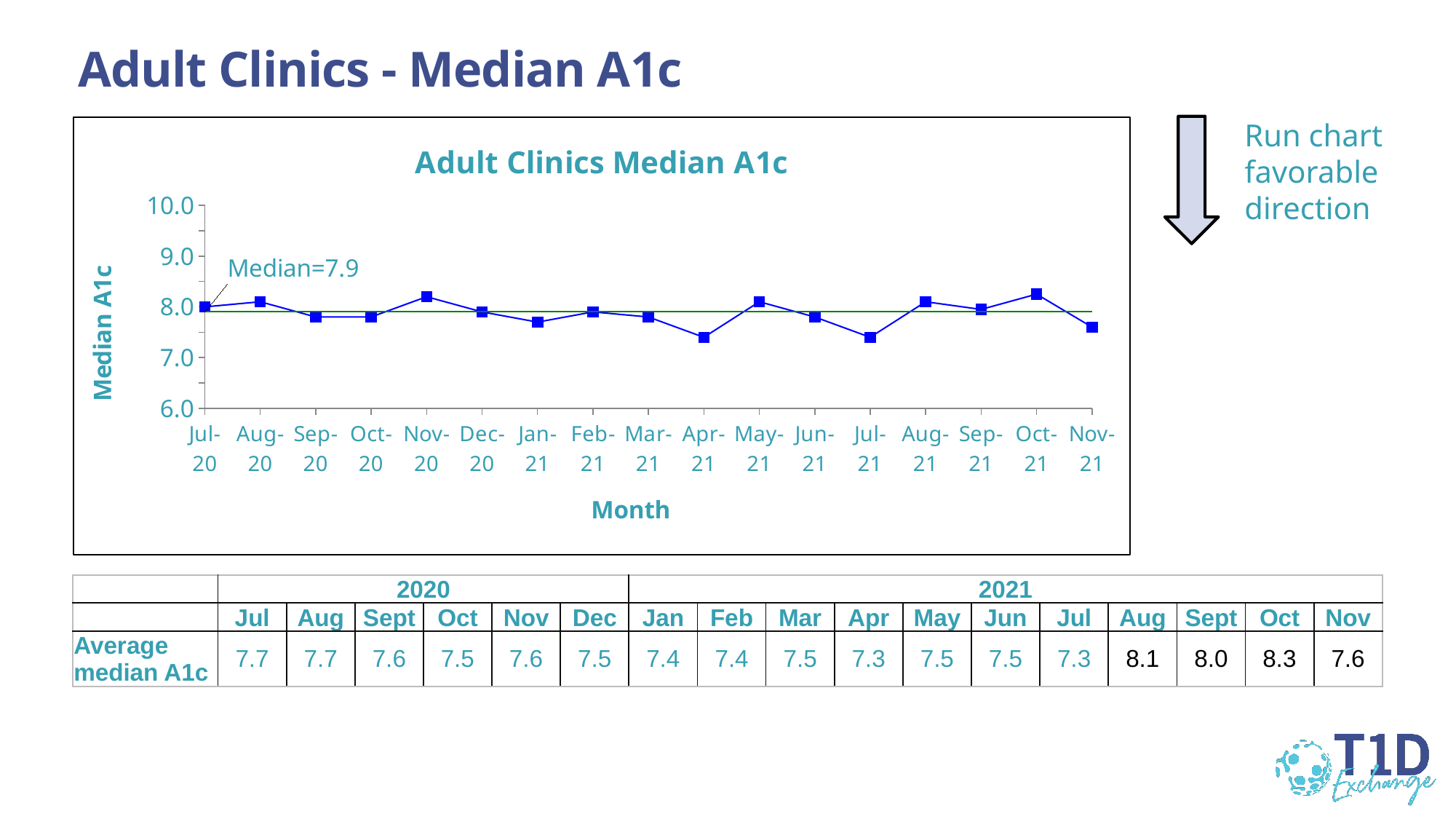
How many monthly data points are plotted on the chart? 17 What is the title of the chart? Adult Clinics Median A1c Is the plotted value for Jul-21 greater or less than 8.0? less Which month has the highest plotted median A1c on the chart? Oct-21 Which has the larger plotted value, Oct-21 or Nov-21? Oct-21 Is the plotted value for Oct-21 greater or less than 8.0? greater Which has the larger plotted value, Nov-20 or Apr-21? Nov-20 Is the plotted value for Nov-20 greater or less than 8.0? greater What median value is annotated on the chart's horizontal reference line? Median=7.9 What is the label of the chart's x axis? Month What kind of chart is shown on the slide? line chart